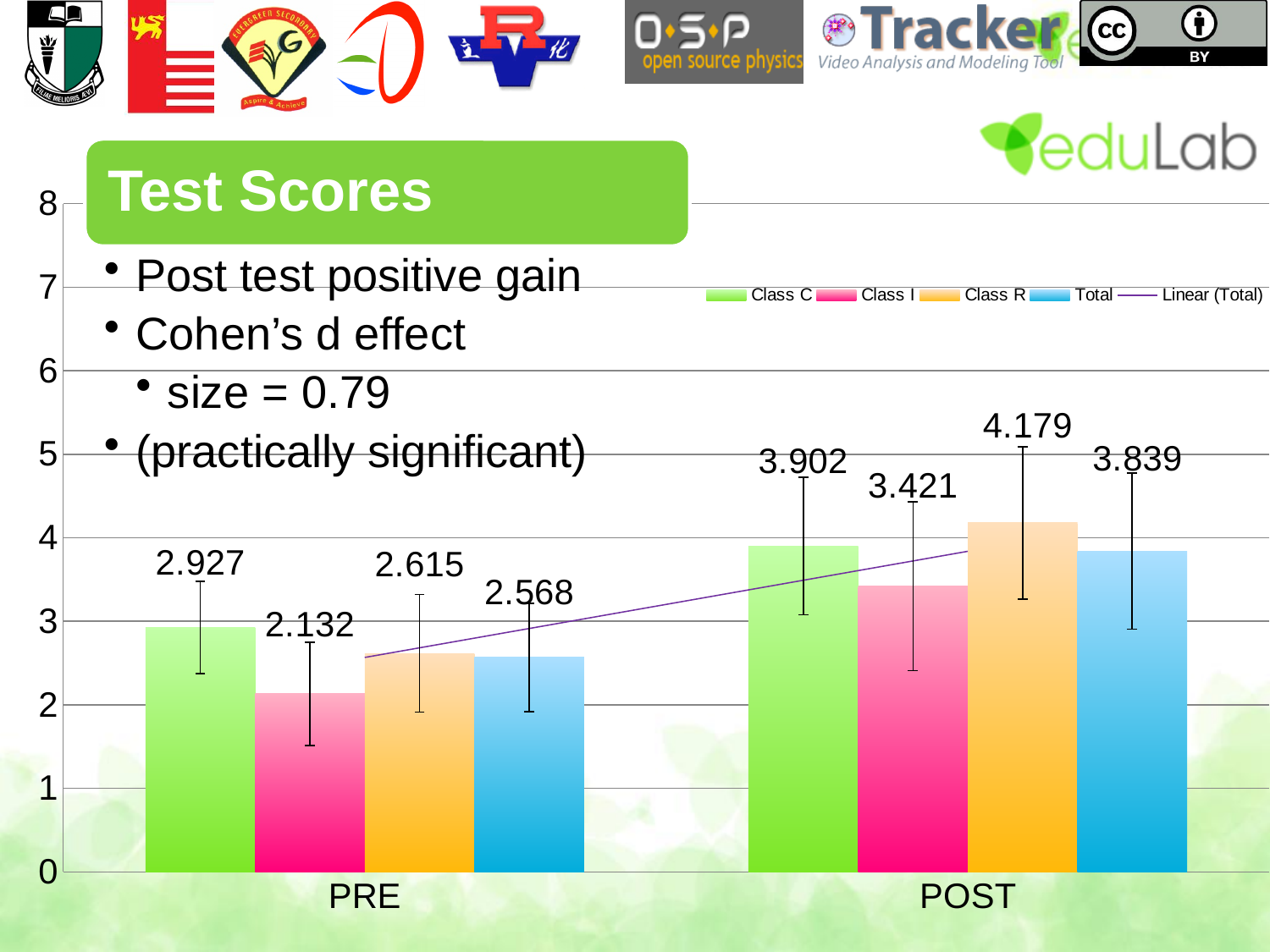
What is the Class R value for POST? 4.179 What is the Total value for PRE? 2.568 How many categories are shown on the x axis? 2 How many entries does the legend list? 5 What is the difference between the Class C POST value and the Class C PRE value? 0.975 What is the difference between the Total POST value and the Total PRE value? 1.271 Which is larger, the Class R value for PRE or the Total value for PRE? Class R What kind of chart is this? Bar chart What is the Class I value for POST? 3.421 Which series has the lowest value in the PRE category? Class I Which series has the highest value in the POST category? Class R What is the Class C value for PRE? 2.927